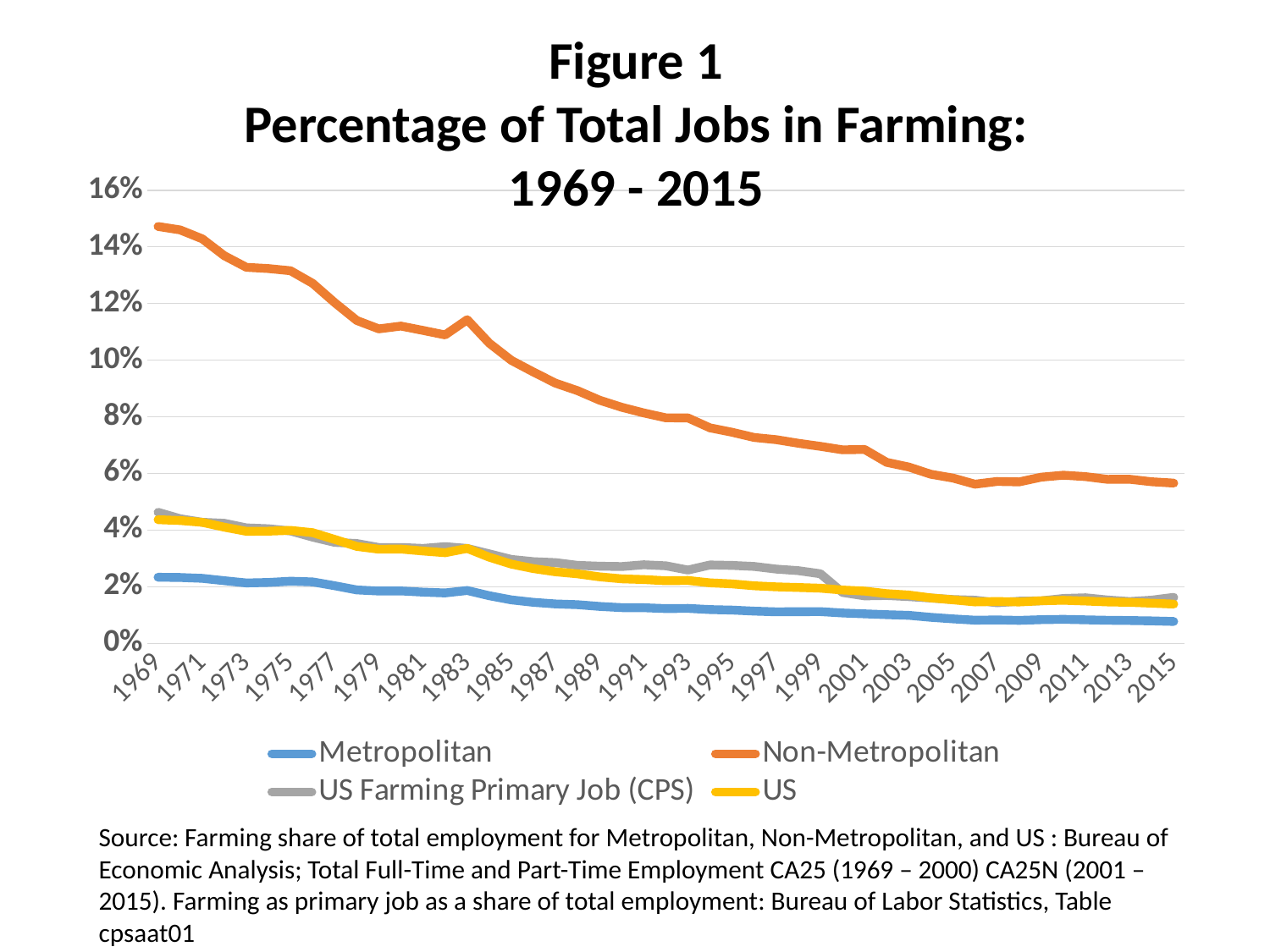
Which series is drawn in orange? Non-Metropolitan Is the value for Non-Metropolitan in 1985 greater or less than 12%? less Does the Non-Metropolitan series generally rise or fall from 1969 to 2015? fall Which is larger in 2015, the value for US or the value for Metropolitan? US Is the value for Non-Metropolitan in 1969 greater or less than 14%? greater Is the value for Metropolitan in 1969 greater or less than 4%? less What is the title of the chart? Figure 1 Percentage of Total Jobs in Farming: 1969 - 2015 What kind of chart is shown on the slide? line chart Which series has the lowest values across the whole period from 1969 to 2015? Metropolitan How many series does the legend list? 4 Which series has the highest values across the whole period from 1969 to 2015? Non-Metropolitan